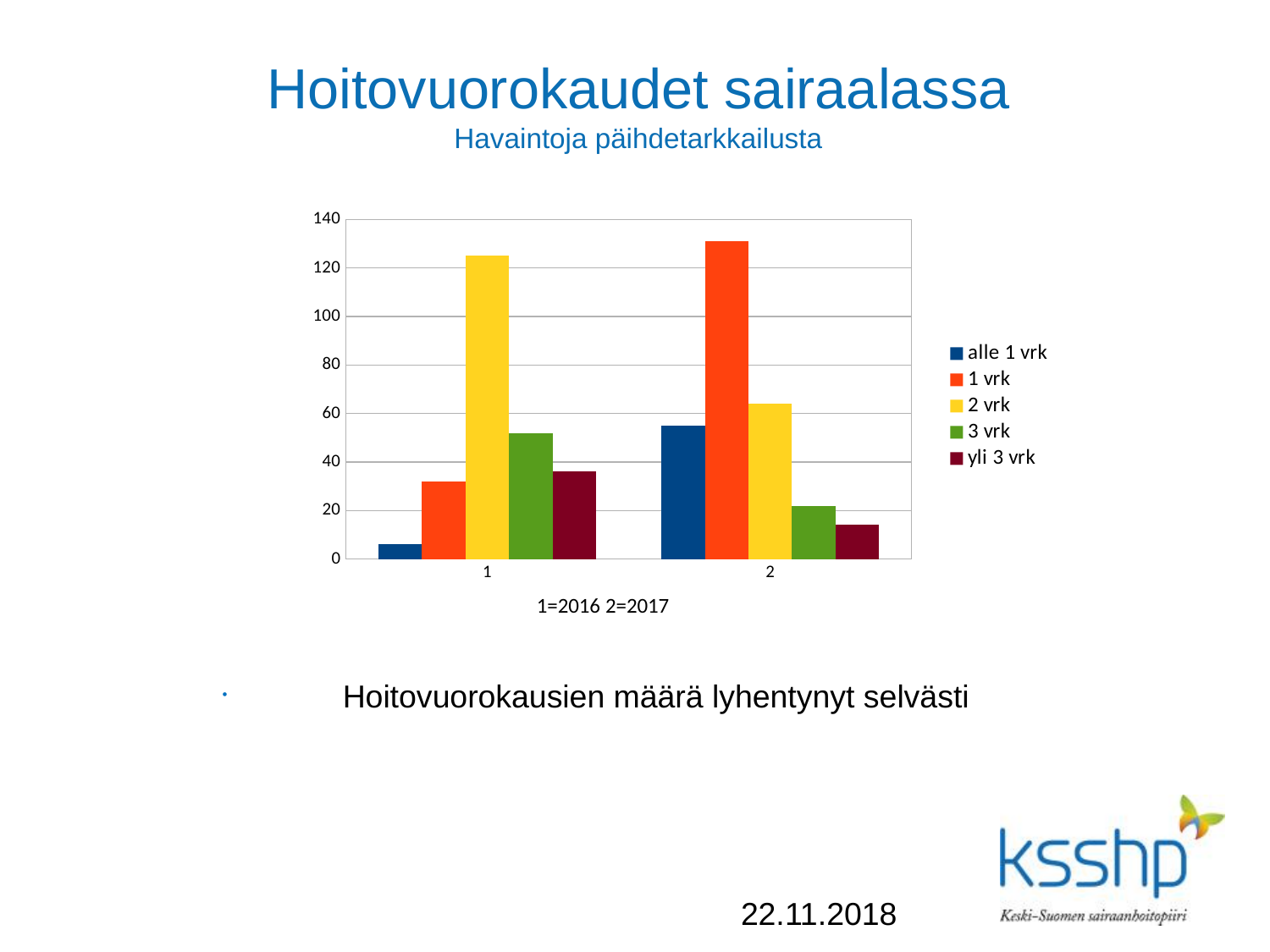
How many series does the legend list? 5 Which series has the lowest bar in category 1? alle 1 vrk How many categories are shown on the x axis? 2 Which series has the highest bar in category 1? 2 vrk According to the x-axis note, which year does category 2 represent? 2017 Which series has the lowest bar in category 2? yli 3 vrk What kind of chart is shown on the slide? bar chart Which series has the highest bar in category 2? 1 vrk Which is larger: the value for alle 1 vrk in category 1 or in category 2? category 2 Is the value for 2 vrk in category 1 greater or less than 120? greater Is the value for 1 vrk in category 2 greater or less than 120? greater Is the value for 3 vrk in category 2 greater or less than 40? less